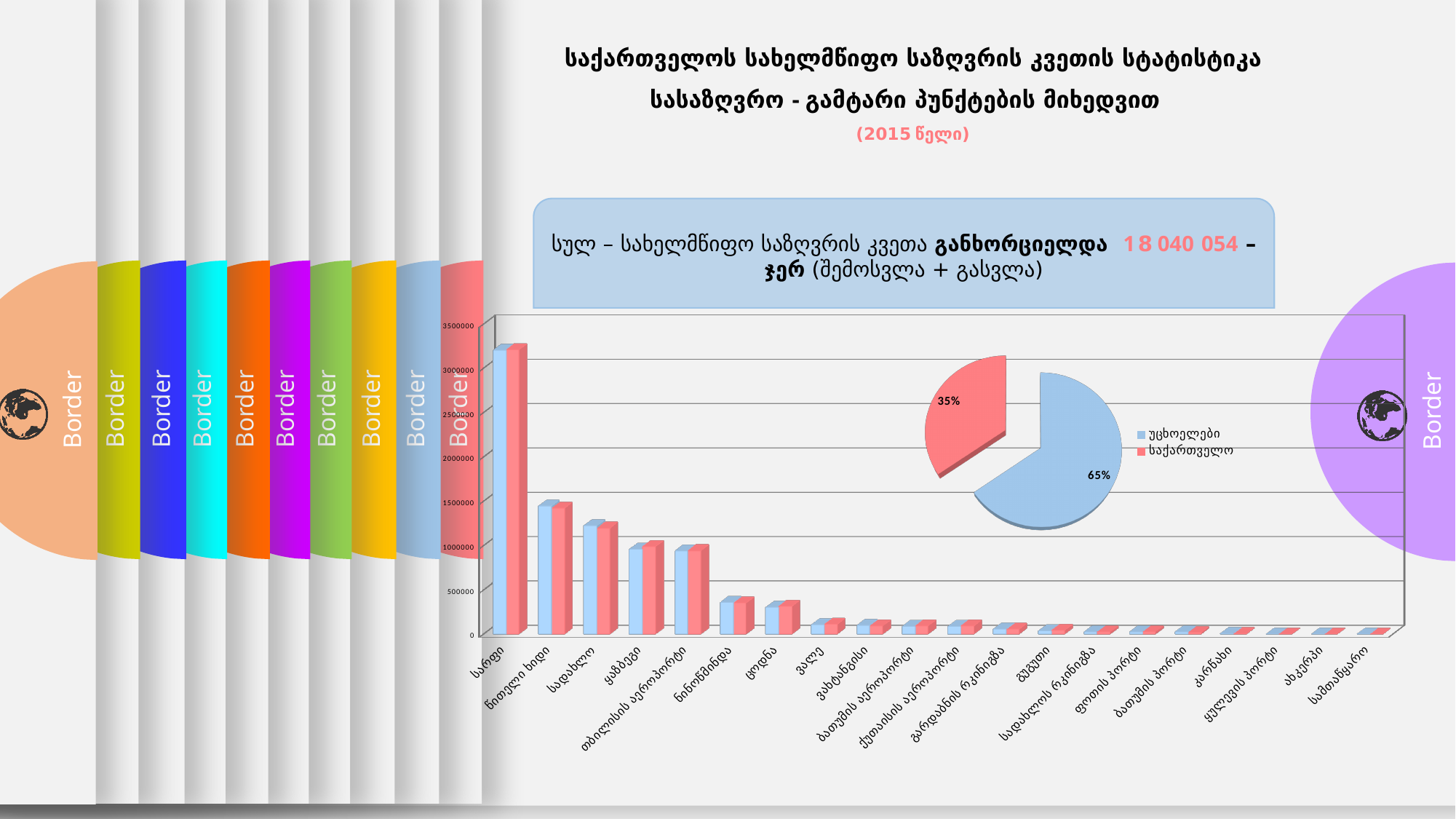
In the pie chart, what share is labelled for the საქართველო slice? 35% In the bar chart, is the value for ნინოწმინდა greater or less than 500000? less In the bar chart, is the value for სარფი greater or less than 3000000? greater In the bar chart, do the values generally rise or fall moving from left to right along the x axis? fall In the pie chart, which slice is larger, უცხოელები or საქართველო? უცხოელები What kind of chart is the chart on the right with the 65% and 35% labels? pie chart How many entries does the pie chart's legend list? 2 In the pie chart, what is the difference in percentage points between the უცხოელები slice and the საქართველო slice? 30 What kind of chart is the large chart at the bottom of the slide with the Georgian category labels along the x axis? bar chart In the bar chart, which category has the highest values? სარფი In the bar chart, is the value for წითელი ხიდი greater or less than 1000000? greater In the pie chart, what share is labelled for the უცხოელები slice? 65%